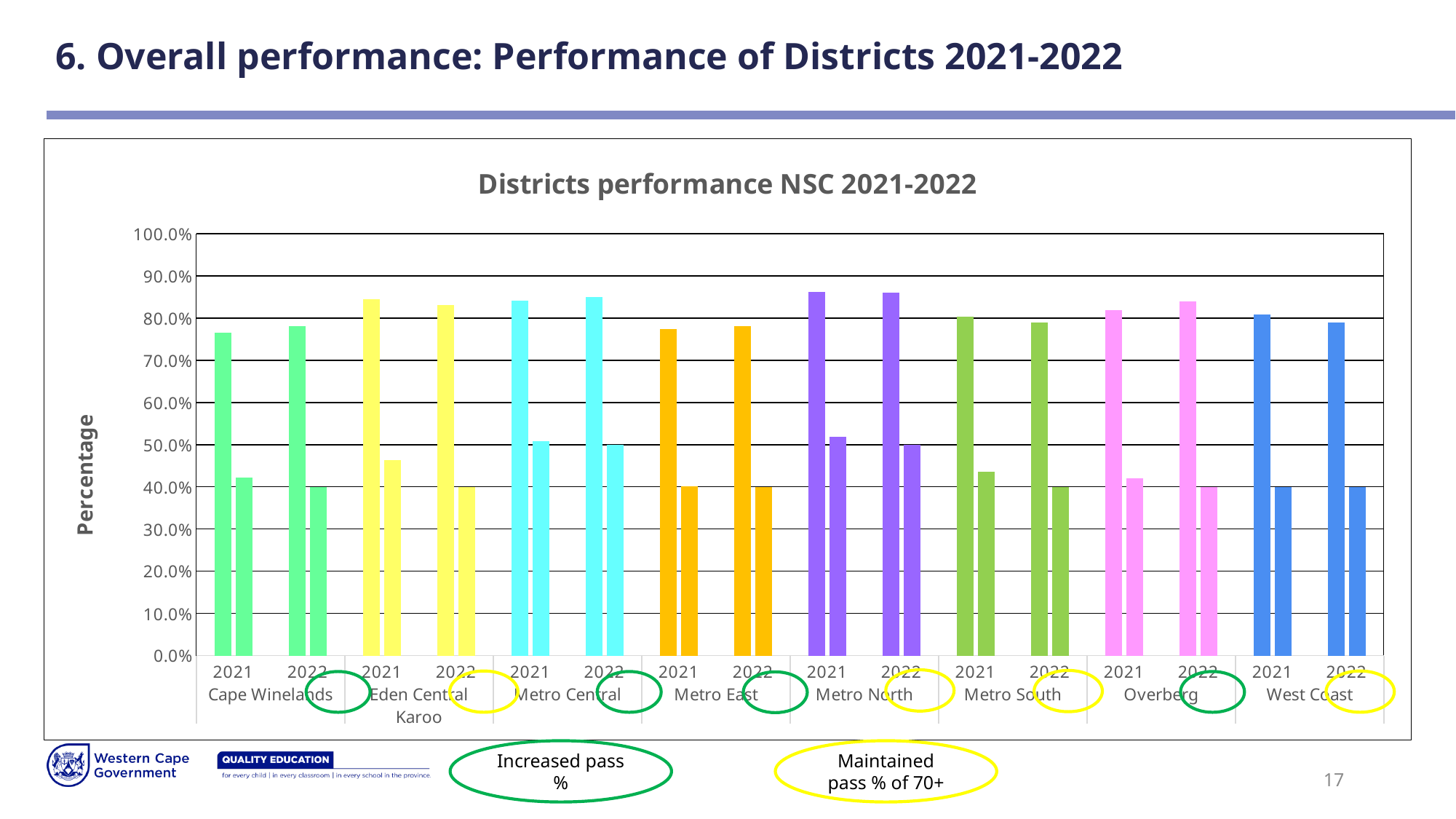
Is the value of the taller bar for Cape Winelands in 2021 greater or less than 80.0%? less Which is larger: the taller bar for Metro North in 2021 or the taller bar for Cape Winelands in 2021? Metro North 2021 According to the annotation below the chart, what does a green circle around a district's 2022 label indicate? Increased pass % Is the value of the taller bar for Metro North in 2021 greater or less than 80.0%? greater What is the title of the chart? Districts performance NSC 2021-2022 Is the value of the shorter bar for Metro North in 2021 greater or less than 60.0%? less How many districts are shown along the x axis of the chart? 8 What kind of chart is shown on the slide? bar chart